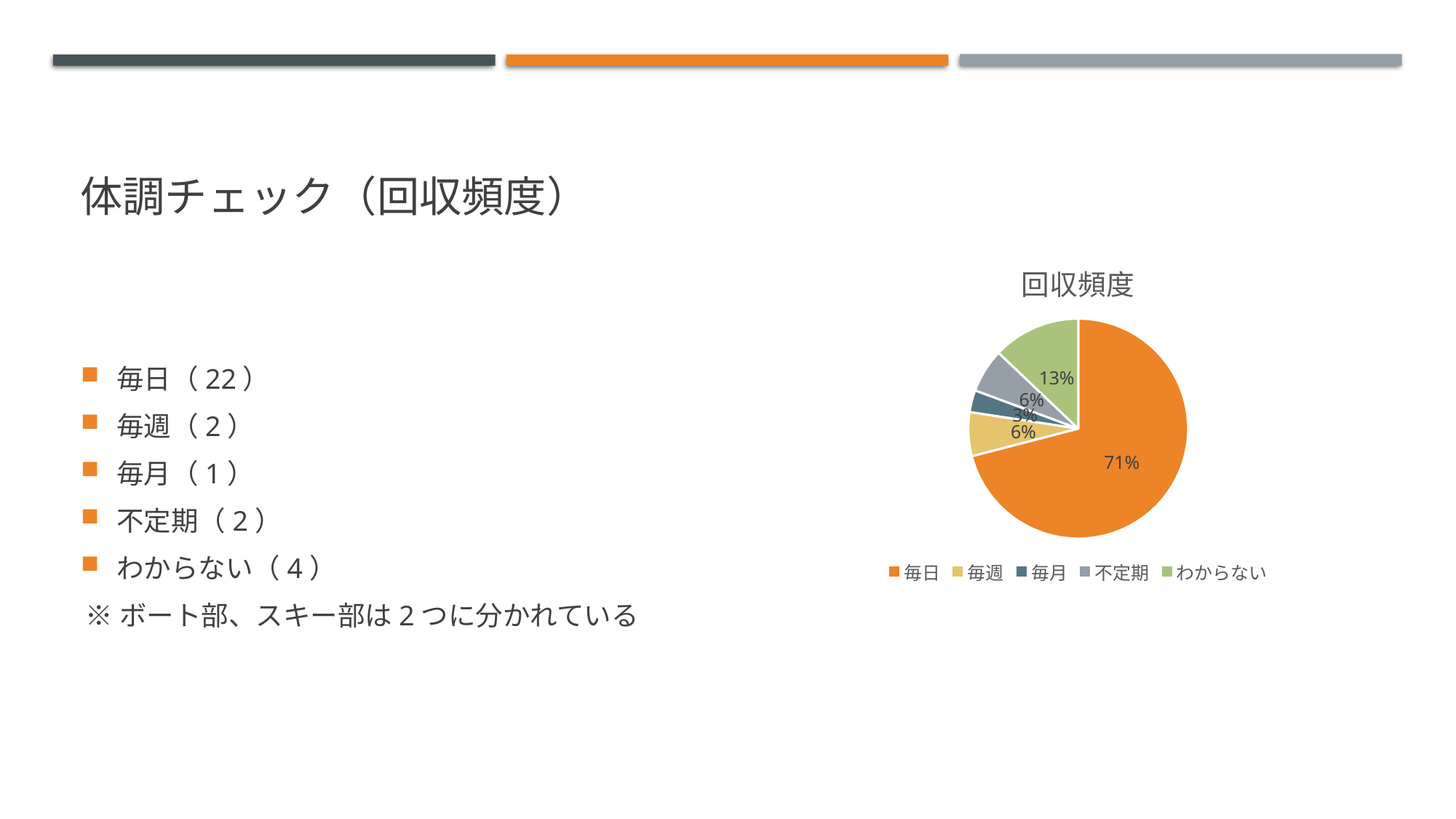
What share of the pie does 毎日 represent? 71% What is the title of the chart? 回収頻度 What share of the pie does 毎週 represent? 6% Which category has the largest slice of the pie? 毎日 Which is larger, the slice for わからない or the slice for 不定期? わからない How many categories does the legend list? 5 What is the difference in percentage points between the 毎日 slice and the わからない slice? 58% What share of the pie does わからない represent? 13% What type of chart is shown on the slide? pie chart What colour is the 毎日 slice in the pie chart? orange Which category has the smallest slice of the pie? 毎月